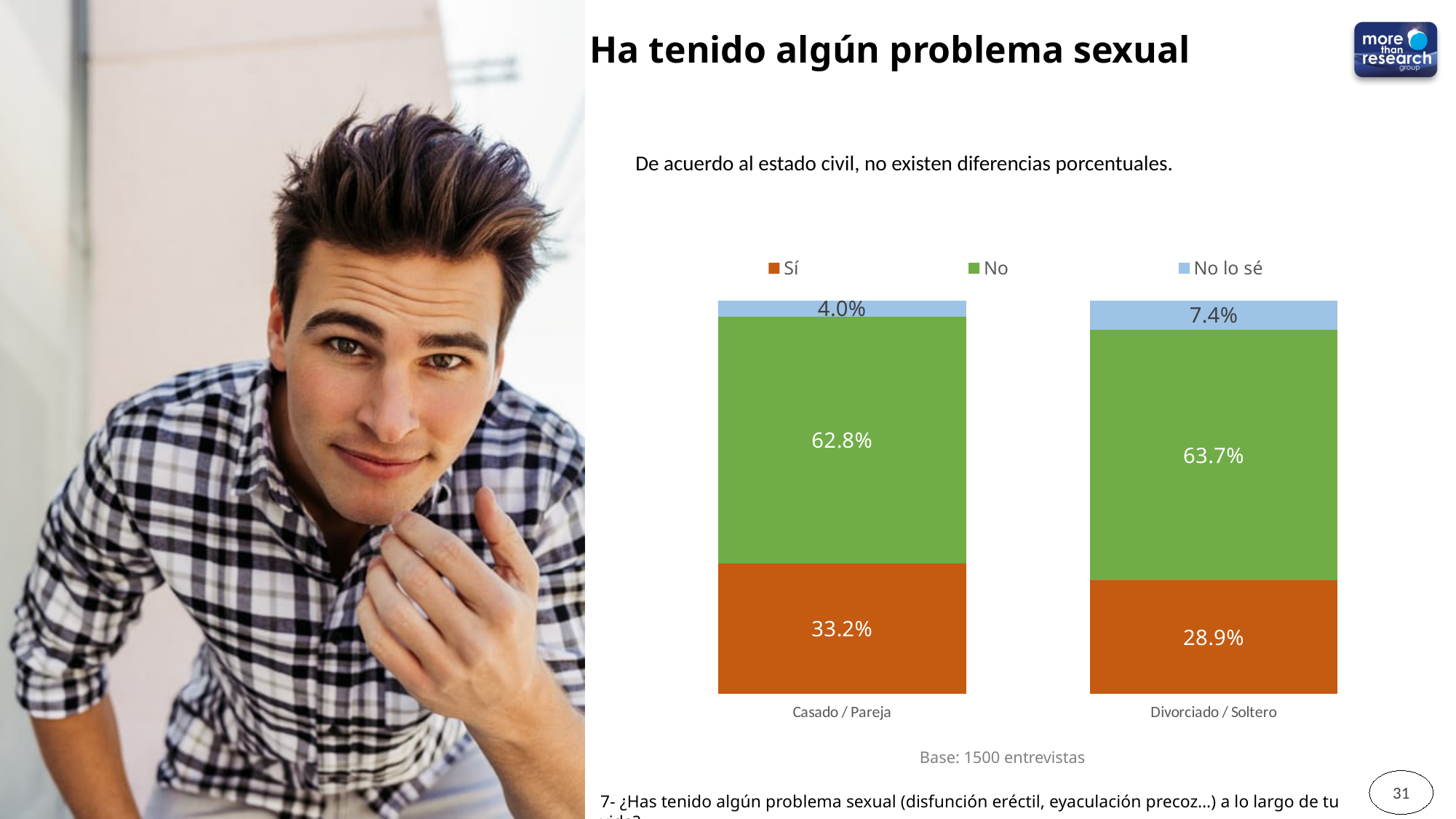
Which category has the higher No lo sé percentage? Divorciado / Soltero What is the difference in percentage points between the No lo sé values for Divorciado / Soltero and Casado / Pareja? 3.4 What is the difference in percentage points between the Sí values for Casado / Pareja and Divorciado / Soltero? 4.3 What percentage of the Casado / Pareja group answered Sí? 33.2% Which colour represents the Sí series in the chart? Orange How many categories are shown on the x axis? 2 What kind of chart is shown on the slide? Stacked bar chart Which category has the higher Sí percentage? Casado / Pareja How many series does the legend list? 3 What percentage of the Divorciado / Soltero group answered No? 63.7% What is the No lo sé value for Divorciado / Soltero? 7.4% What is the No lo sé value for Casado / Pareja? 4.0%